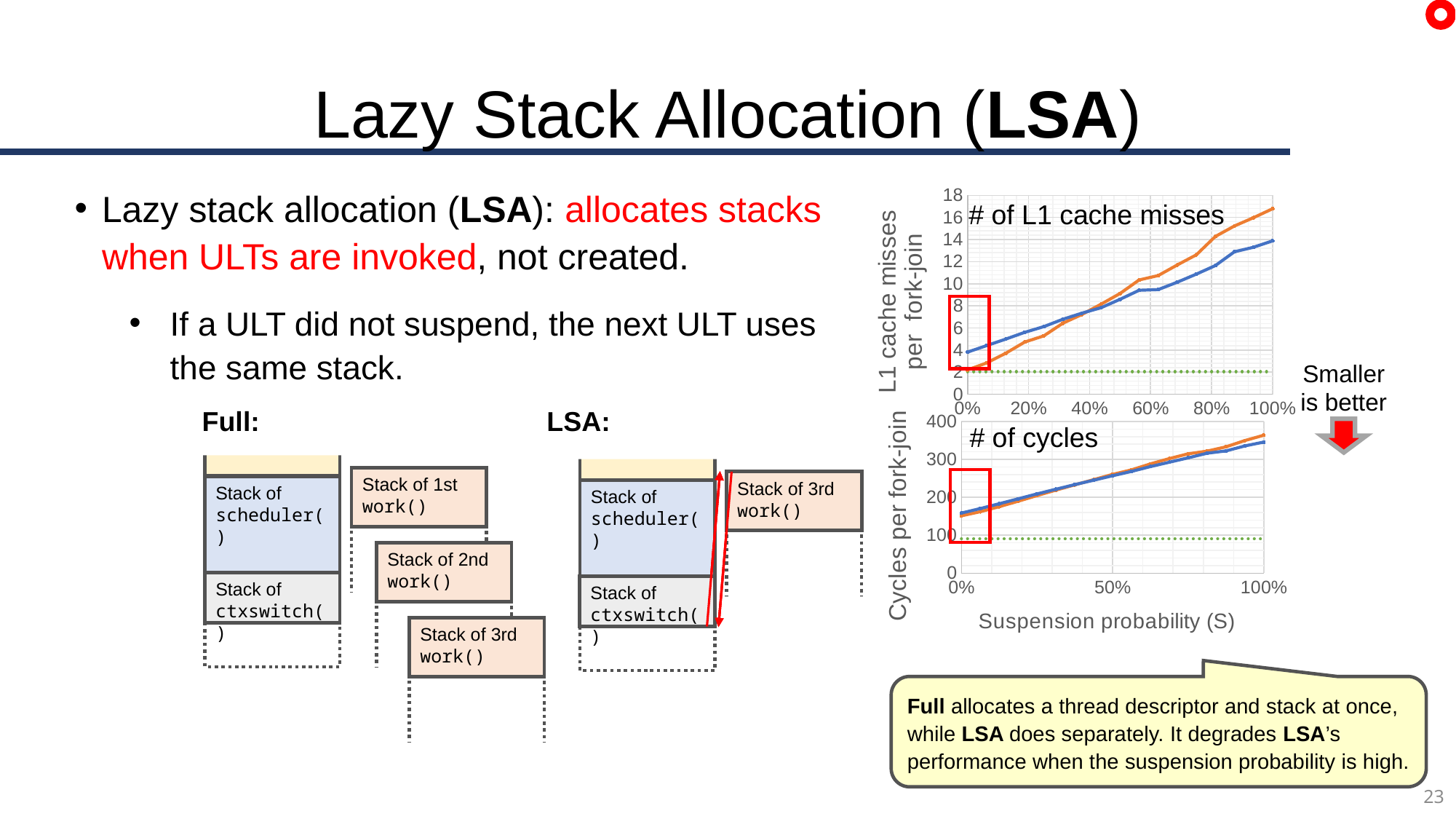
In the '# of cycles' chart, is the value of the orange line at 100% greater or less than 300? greater In the '# of cycles' chart, is the value of the blue line at 0% greater or less than 100? greater What kind of chart is the '# of L1 cache misses' chart? line chart In the '# of L1 cache misses' chart, is the value of the blue line at 100% greater or less than 10? greater In the '# of cycles' chart, do the blue and orange lines rise or fall as suspension probability increases? rise What kind of chart is the '# of cycles' chart? line chart What is the x-axis label shared by the two charts? Suspension probability (S) In the '# of L1 cache misses' chart, do the blue and orange lines rise or fall as suspension probability increases? rise What is the y-axis label of the '# of cycles' chart? Cycles per fork-join